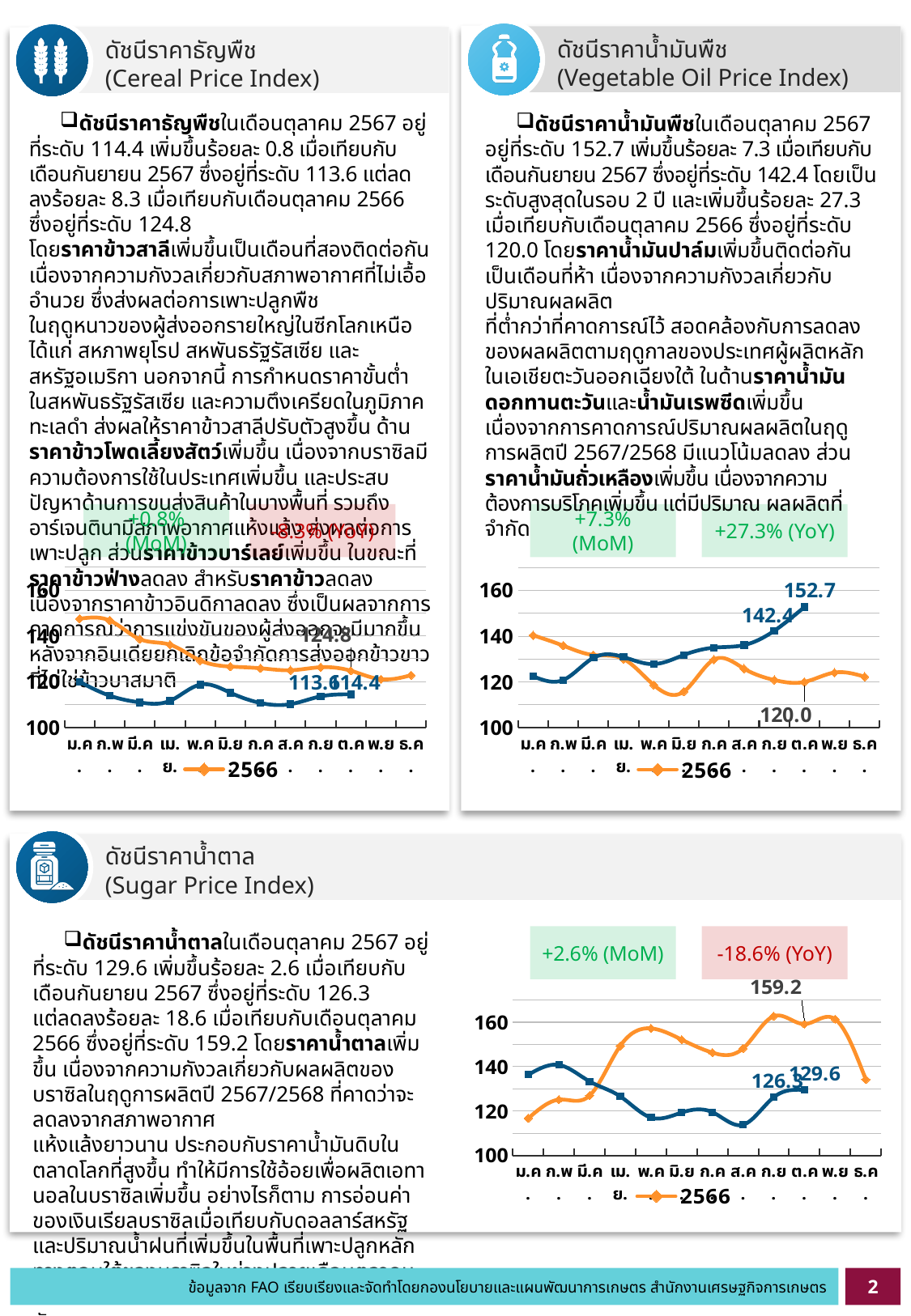
In the Cereal Price Index chart, is the orange 2566 line's value for January (ม.ค.) greater or less than 140? greater In the Sugar Price Index chart, what is the difference between the labelled October values of the orange 2566 line (159.2) and the blue line (129.6)? 29.6 In the Cereal Price Index chart, what is the difference between the labelled October values of the orange 2566 line (124.8) and the blue line (114.4)? 10.4 What kind of chart is used in the Cereal Price Index panel? Line chart In the Vegetable Oil Price Index chart, what value is labelled for October (ต.ค.) on the blue line? 152.7 How many months are shown on the x axis of the Sugar Price Index chart? 12 In the Sugar Price Index chart, what value is labelled for October (ต.ค.) on the orange 2566 line? 159.2 In the Vegetable Oil Price Index chart, which October value is larger: the blue line (152.7) or the orange 2566 line (120.0)? The blue line (152.7) In the Vegetable Oil Price Index chart, what value is labelled for September (ก.ย.) on the blue line? 142.4 In the Cereal Price Index chart, what value is labelled for October (ต.ค.) on the blue line? 114.4 In the Cereal Price Index chart, what value is labelled for October (ต.ค.) on the orange 2566 line? 124.8 In the Vegetable Oil Price Index chart, what is the difference between the labelled blue-line values for October (152.7) and September (142.4)? 10.3